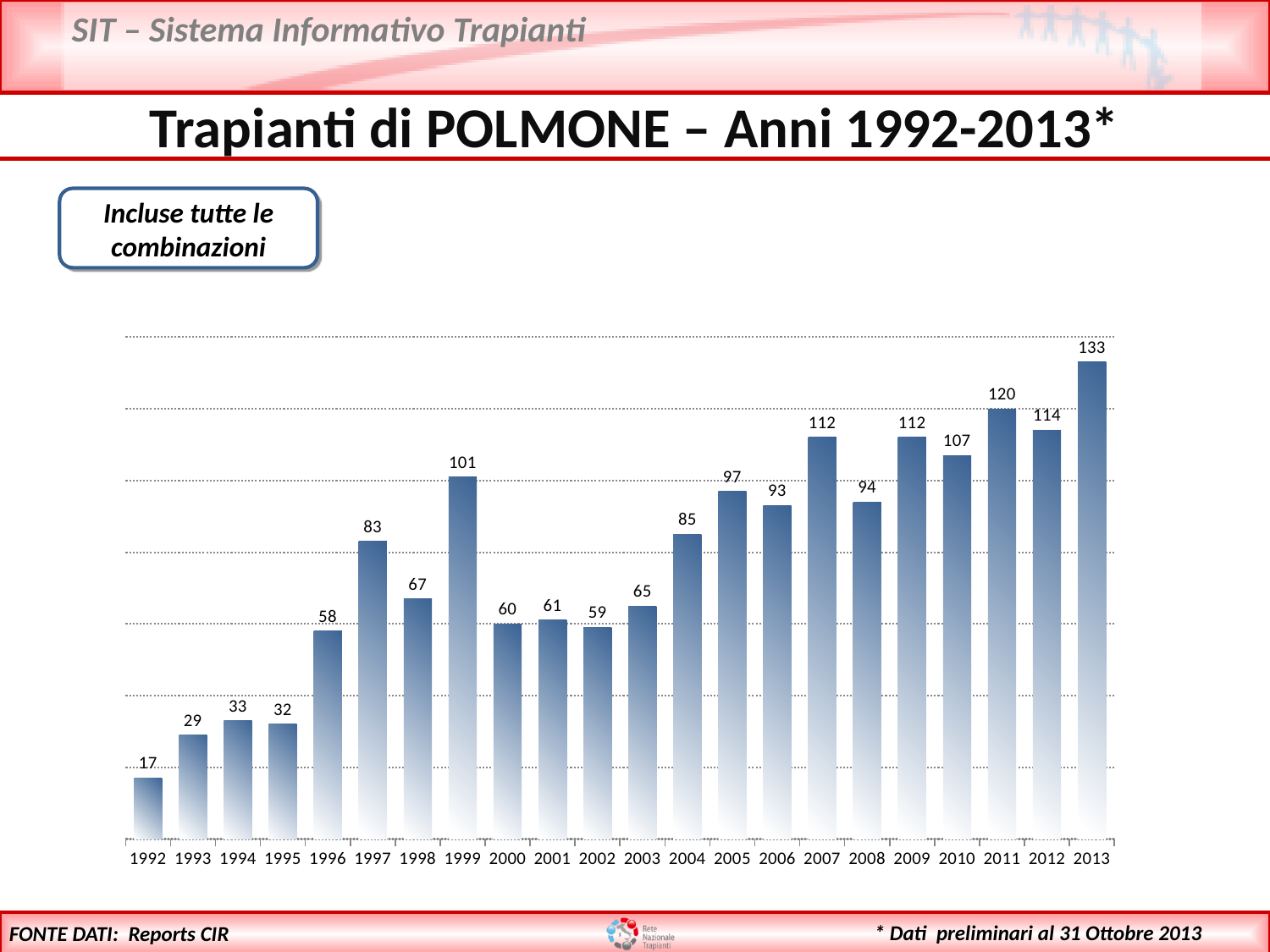
Which year has the lowest value? 1992 How many years are shown on the x axis? 22 Which is larger, the value for 2007 or the value for 2008? 2007 What is the value for 1999? 101 What is the difference between the values for 2013 and 2012? 19 What is the title of the slide containing the chart? Trapianti di POLMONE – Anni 1992-2013* What is the difference between the values for 1997 and 1998? 16 What is the value for 1992? 17 Do the values generally rise or fall from 1992 to 2013? rise What kind of chart is this? bar chart Which year has the highest value? 2013 What is the value for 2013? 133